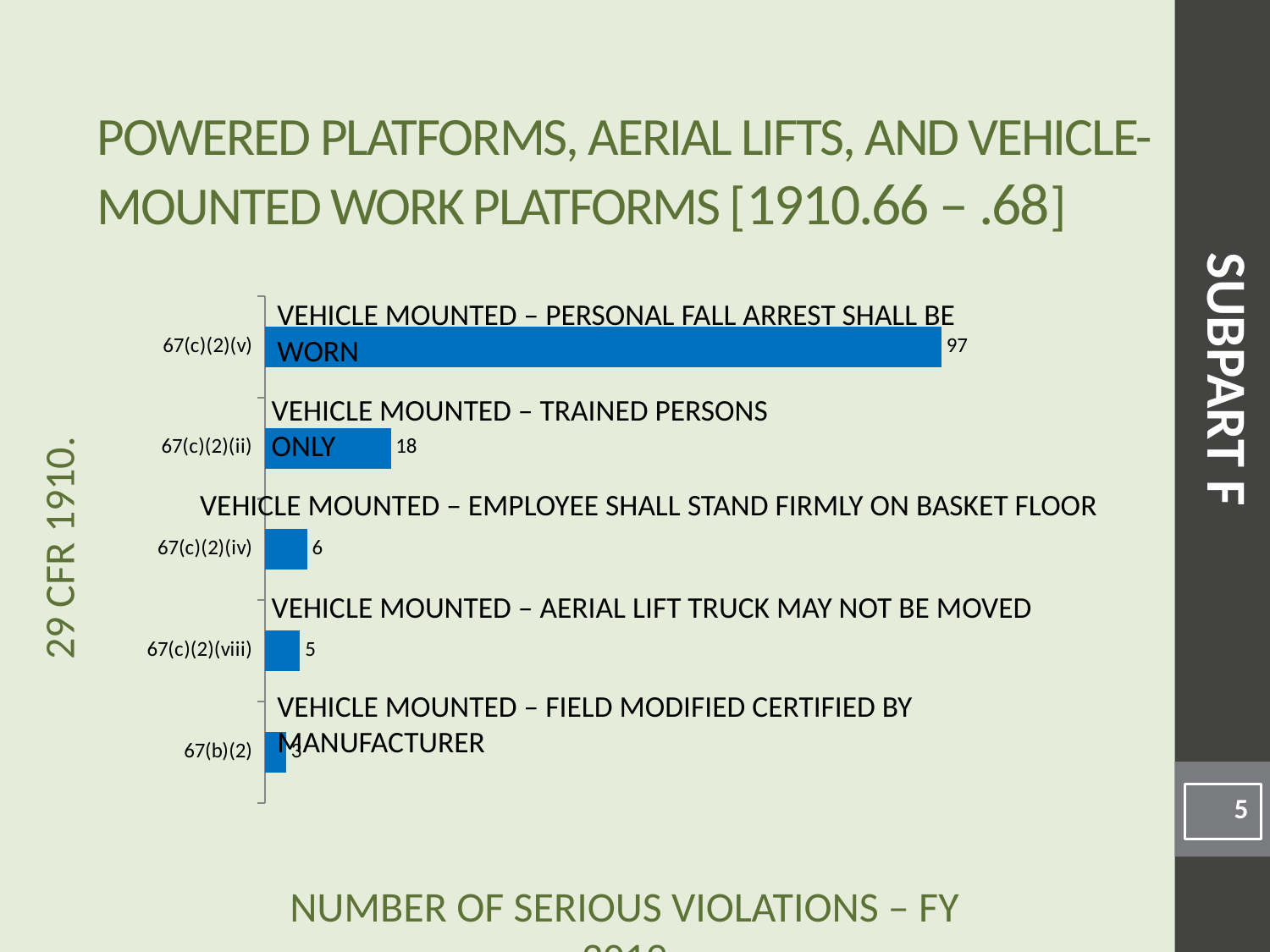
Which has more serious violations, 67(c)(2)(iv) or 67(c)(2)(viii)? 67(c)(2)(iv) What is the number of serious violations for 67(c)(2)(viii)? 5 What is the number of serious violations for 67(c)(2)(iv)? 6 What is the difference between the number of violations for 67(c)(2)(ii) and 67(c)(2)(iv)? 12 How many standards (bars) are shown in the chart? 5 What type of chart is shown on the slide? Bar chart What is the number of serious violations for 67(c)(2)(ii)? 18 Which standard has the lowest number of serious violations? 67(b)(2) Which standard has the highest number of serious violations? 67(c)(2)(v) What is the difference between the number of violations for 67(c)(2)(v) and 67(c)(2)(ii)? 79 What is the number of serious violations for 67(c)(2)(v)? 97 What description is given for the 67(c)(2)(ii) bar? VEHICLE MOUNTED – TRAINED PERSONS ONLY